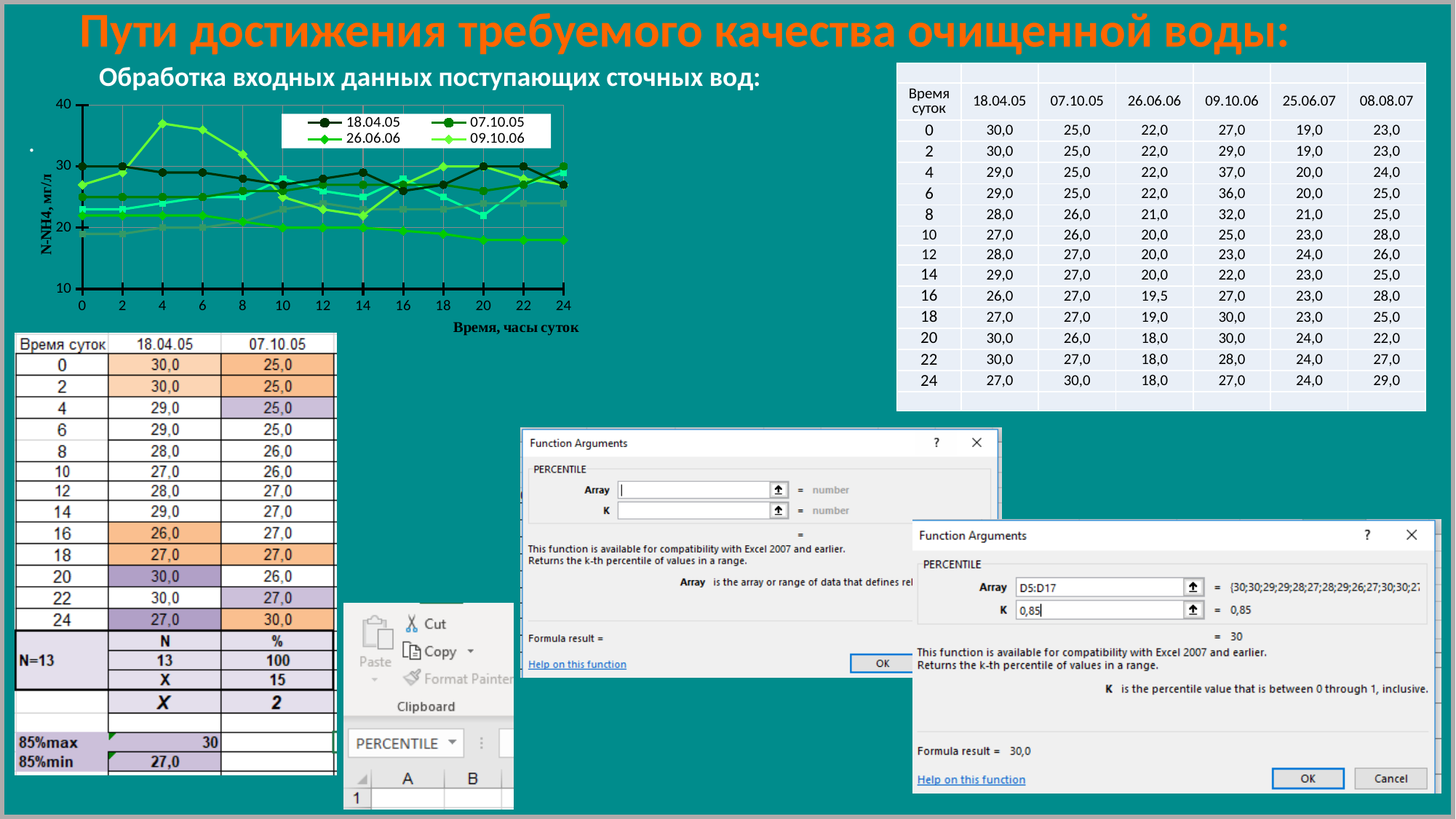
Is the value of the 26.06.06 series at hour 24 greater or less than 20? less According to the table on the slide, what is the value of the 09.10.06 series at hour 4? 37,0 What is the label of the x axis of the chart? Время, часы суток What kind of chart is shown on the slide? line chart How many series does the chart legend list? 4 What is the label of the y axis of the chart? N-NH4, мг/л Which series is larger at hour 4: 09.10.06 or 18.04.05? 09.10.06 Is the value of the 09.10.06 series at hour 4 greater or less than 30? greater How many time points are marked along the x axis of the chart? 13 At which hour does the 09.10.06 series reach its highest value on the chart? 4 Does the 26.06.06 series rise or fall from hour 0 to hour 24? fall According to the table on the slide, what is the difference between the 09.10.06 and 18.04.05 values at hour 4? 8,0